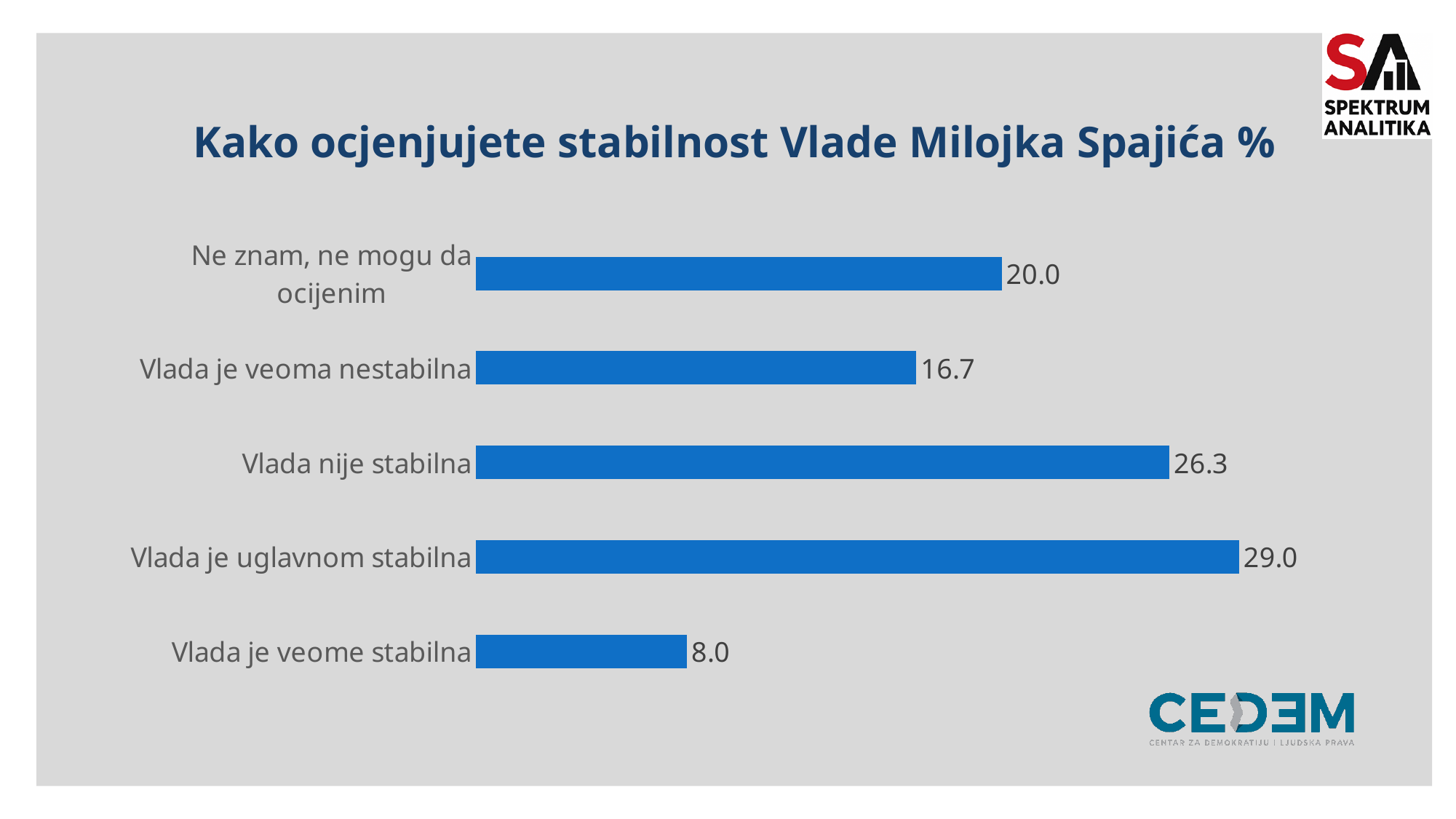
Which category has the lowest value? Vlada je veome stabilna What is the title of the chart? Kako ocjenjujete stabilnost Vlade Milojka Spajića % How many categories are shown in the chart? 5 What is the value for "Ne znam, ne mogu da ocijenim"? 20.0 What is the value for "Vlada je veoma nestabilna"? 16.7 Which category has the highest value? Vlada je uglavnom stabilna What is the value for "Vlada je uglavnom stabilna"? 29.0 What is the difference between the values for "Ne znam, ne mogu da ocijenim" and "Vlada je veome stabilna"? 12.0 What kind of chart is shown on the slide? Bar chart Which is larger, the value for "Vlada nije stabilna" or the value for "Vlada je veoma nestabilna"? Vlada nije stabilna What is the value for "Vlada je veome stabilna"? 8.0 What is the difference between the values for "Vlada je uglavnom stabilna" and "Vlada nije stabilna"? 2.7